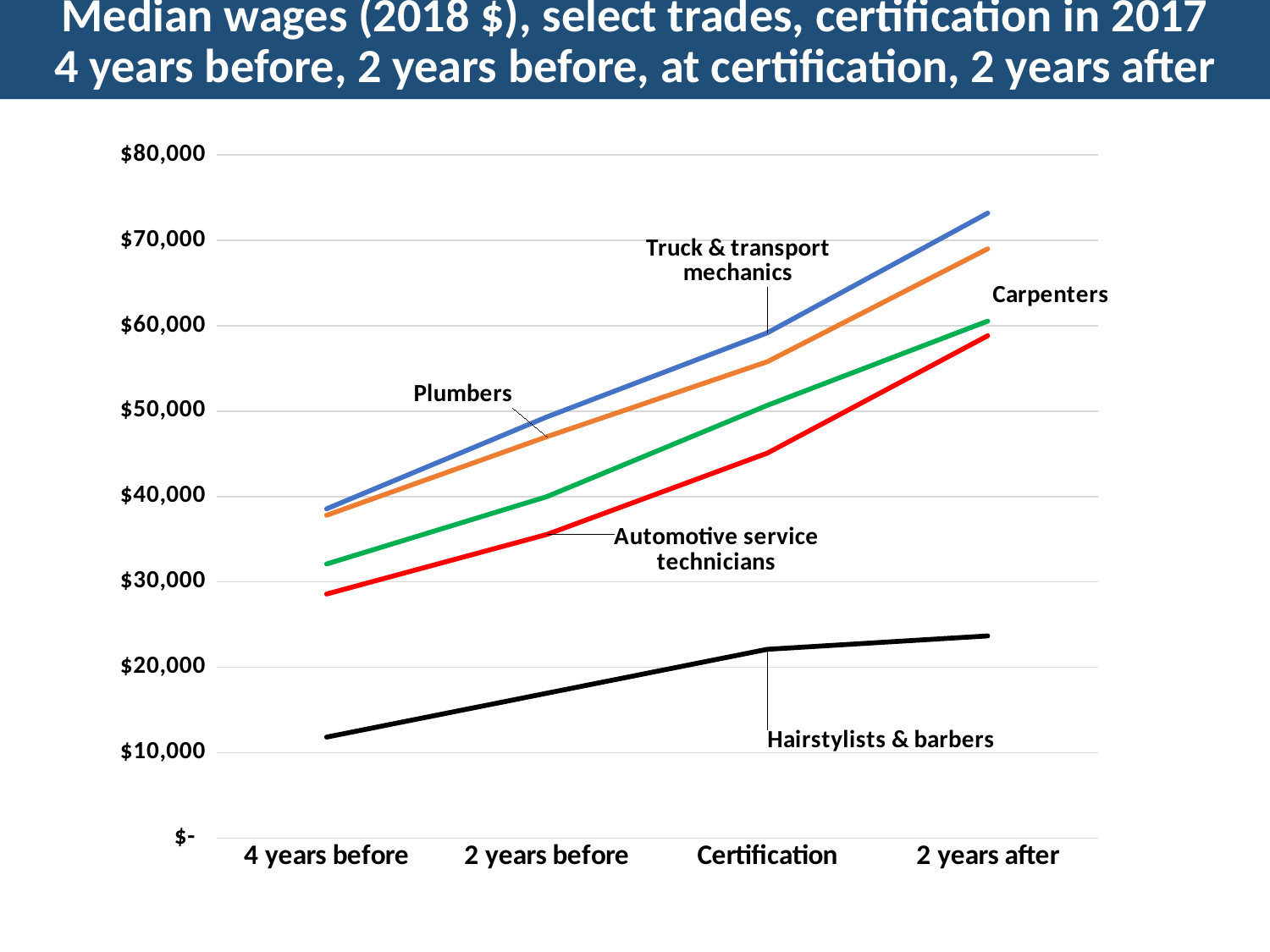
How many time points are shown along the x axis? 4 Do the median wages for Carpenters rise or fall from 4 years before to 2 years after certification? rise Which trade has the highest median wage at 2 years after certification? Truck & transport mechanics Which trade has the lowest median wage at every time point? Hairstylists & barbers Is the median wage for Automotive service technicians at certification greater or less than $50,000? less What is the label of the x-axis category between '2 years before' and '2 years after'? Certification At 4 years before certification, which has the higher median wage: Carpenters or Automotive service technicians? Carpenters At certification, which has the higher median wage: Plumbers or Carpenters? Plumbers Is the median wage for Hairstylists & barbers at 4 years before certification greater or less than $20,000? less Is the median wage for Truck & transport mechanics at 2 years after certification greater or less than $70,000? greater How many trades (lines) are plotted on the chart? 5 What kind of chart is shown on the slide? line chart